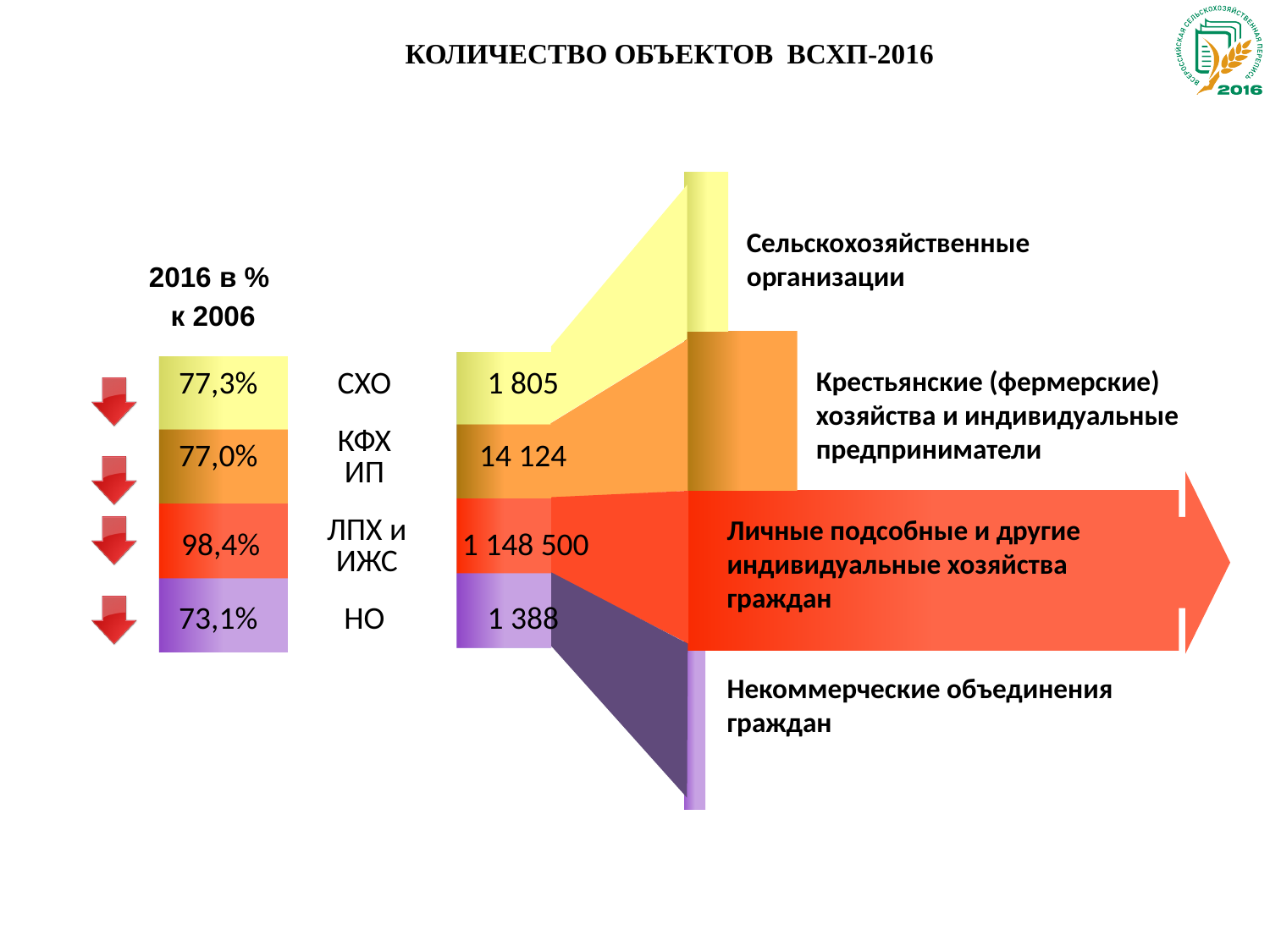
What is the value of 2016 as a percentage of 2006 for СХО? 77,3% Which has more objects, КФХ ИП or СХО? КФХ ИП What is the number of objects shown for КФХ ИП? 14 124 What is the difference between the number of objects for СХО and for НО? 417 How many categories of objects are shown on the slide? 4 What is the number of objects shown for НО? 1 388 What is the number of objects shown for ЛПХ и ИЖС? 1 148 500 What is the number of objects shown for СХО? 1 805 Which category has the largest number of objects? ЛПХ и ИЖС Which category has the lowest value of 2016 in % to 2006? НО Which category has the smallest number of objects? НО What is the value of 2016 as a percentage of 2006 for ЛПХ и ИЖС? 98,4%